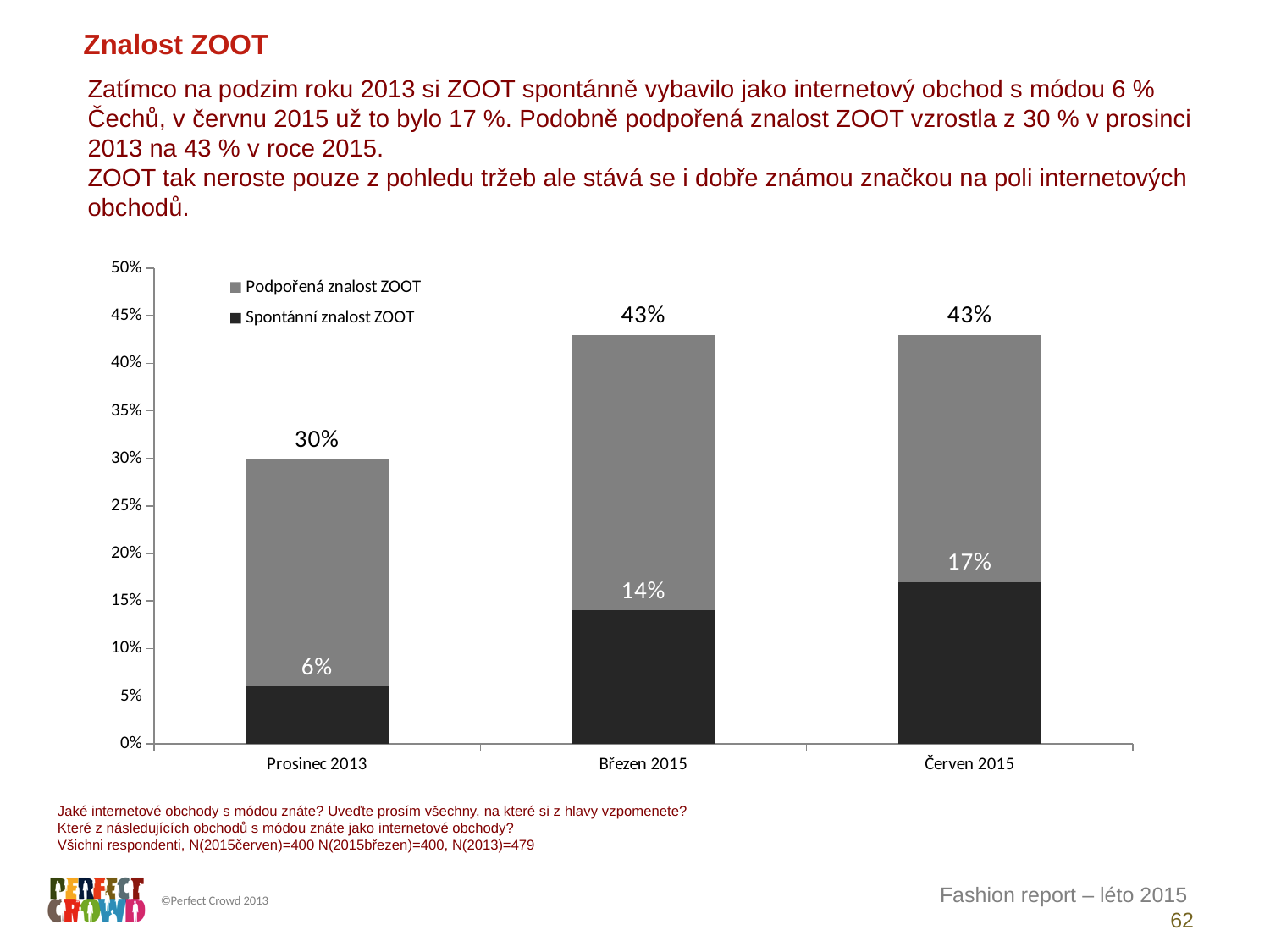
In which period is Spontánní znalost ZOOT highest? Červen 2015 How many time periods are shown on the x axis? 3 What kind of chart is shown on the slide? bar chart What is the value of Spontánní znalost ZOOT for Březen 2015? 14% How many series does the legend list? 2 What is the value of Podpořená znalost ZOOT for Prosinec 2013? 30% What is the difference between Spontánní znalost ZOOT in Červen 2015 and Prosinec 2013? 11% In which period is Spontánní znalost ZOOT lowest? Prosinec 2013 Does Spontánní znalost ZOOT rise or fall from Prosinec 2013 to Červen 2015? rise What is the value of Spontánní znalost ZOOT for Červen 2015? 17% What is the value of Spontánní znalost ZOOT for Prosinec 2013? 6% What is the value of Podpořená znalost ZOOT for Červen 2015? 43%